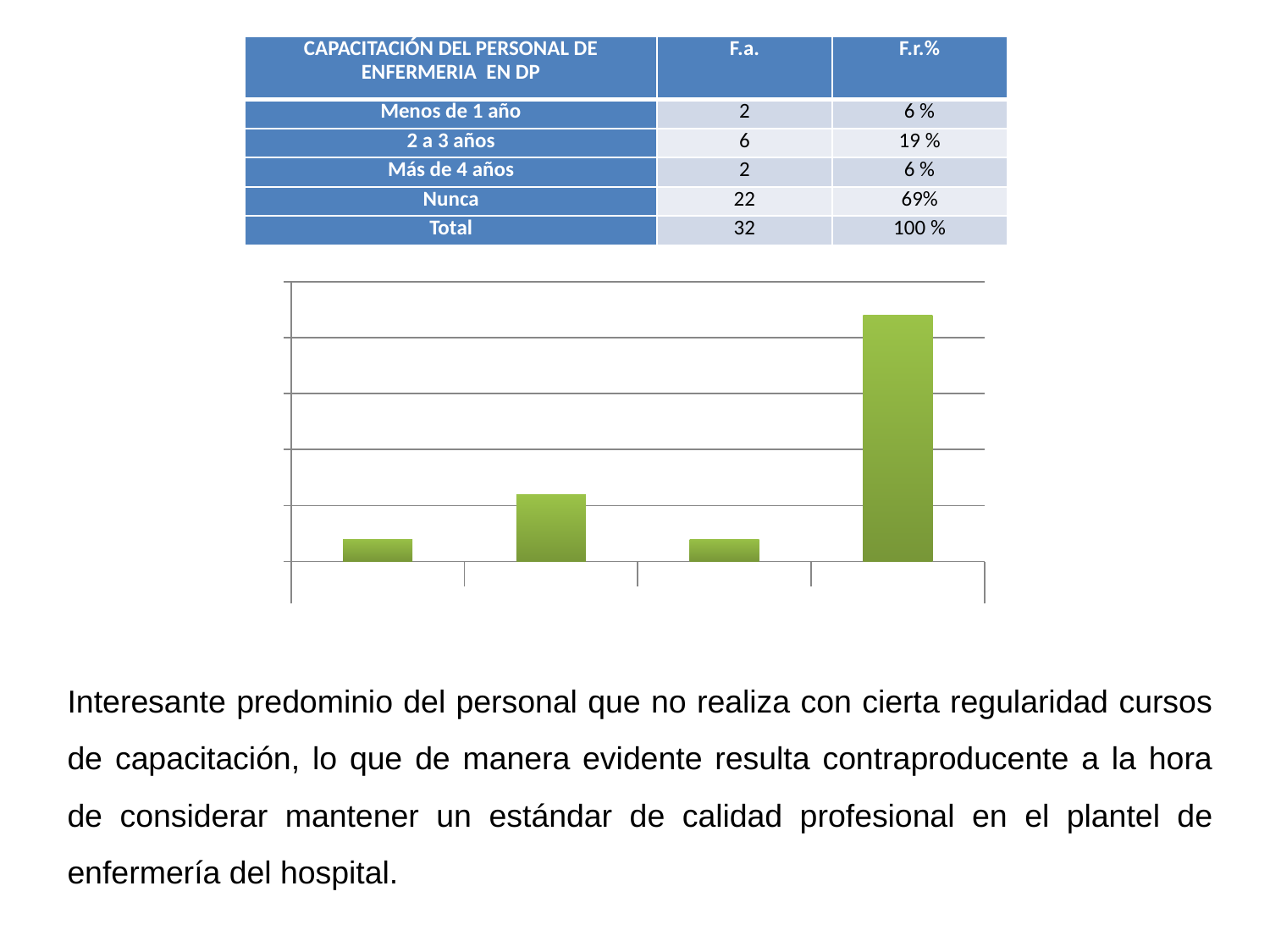
Which bar in the chart is the tallest, counting from the left? the fourth bar Is the fourth bar from the left taller or shorter than the second bar? taller What kind of chart is shown on the slide? bar chart Does the chart display a legend? No What colour are the bars in the chart? green Is the second bar from the left taller or shorter than the first bar? taller Is the third bar from the left taller or shorter than the fourth bar? shorter How many bars does the chart contain? 4